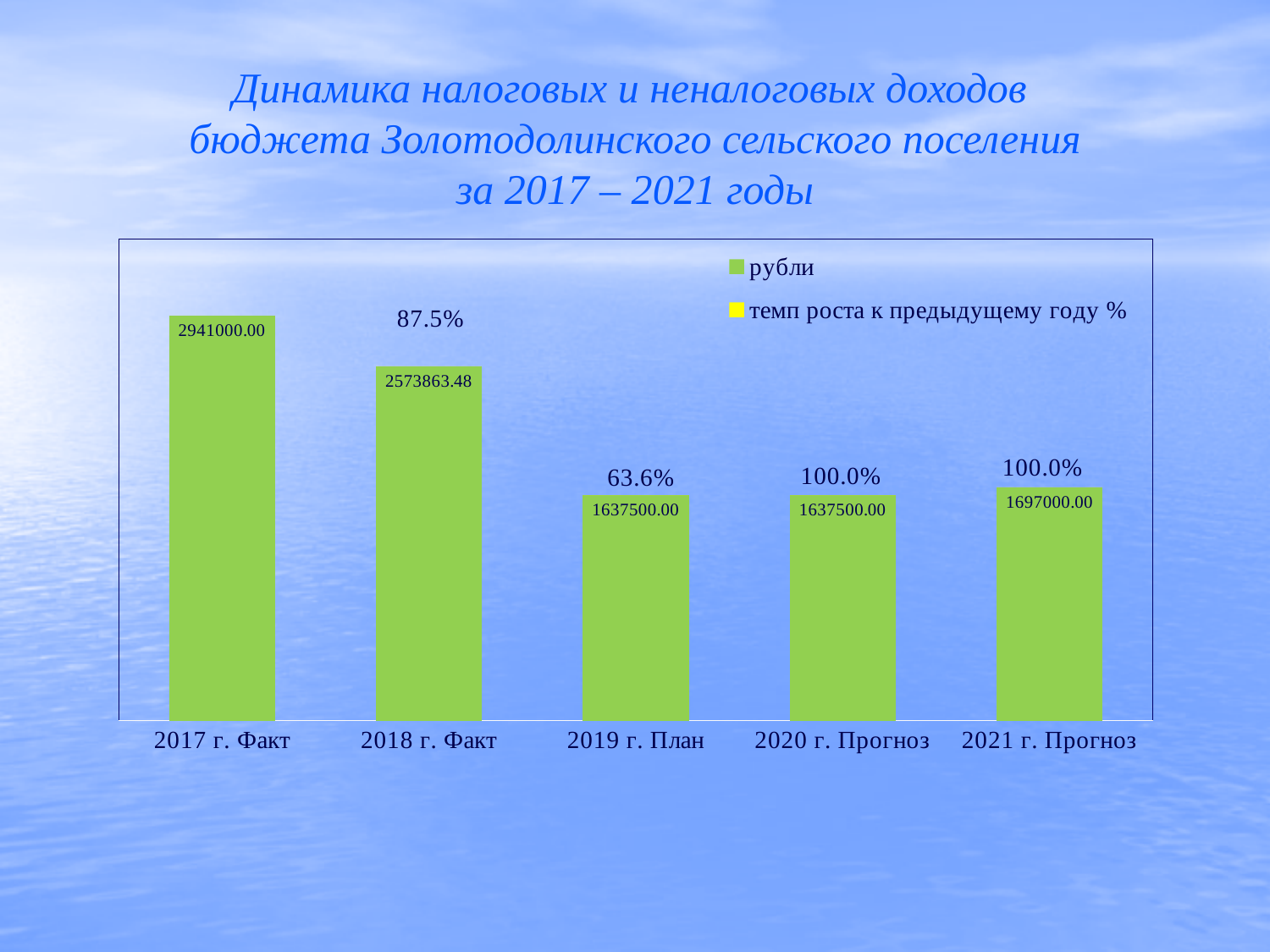
What is the growth rate to the previous year (темп роста) shown for 2018 г. Факт? 87.5% What type of chart is shown on the slide? bar chart What is the growth rate to the previous year (темп роста) shown for 2019 г. План? 63.6% Which is larger, the value for 2018 г. Факт or the value for 2019 г. План? 2018 г. Факт What is the value in rubles for 2017 г. Факт? 2941000.00 How many categories are shown on the x axis? 5 What is the difference in rubles between 2017 г. Факт and 2018 г. Факт? 367136.52 How many series does the legend list? 2 What is the value in rubles for 2018 г. Факт? 2573863.48 What is the value in rubles for 2021 г. Прогноз? 1697000.00 Which category has the highest value in rubles? 2017 г. Факт What is the difference in rubles between 2021 г. Прогноз and 2020 г. Прогноз? 59500.00